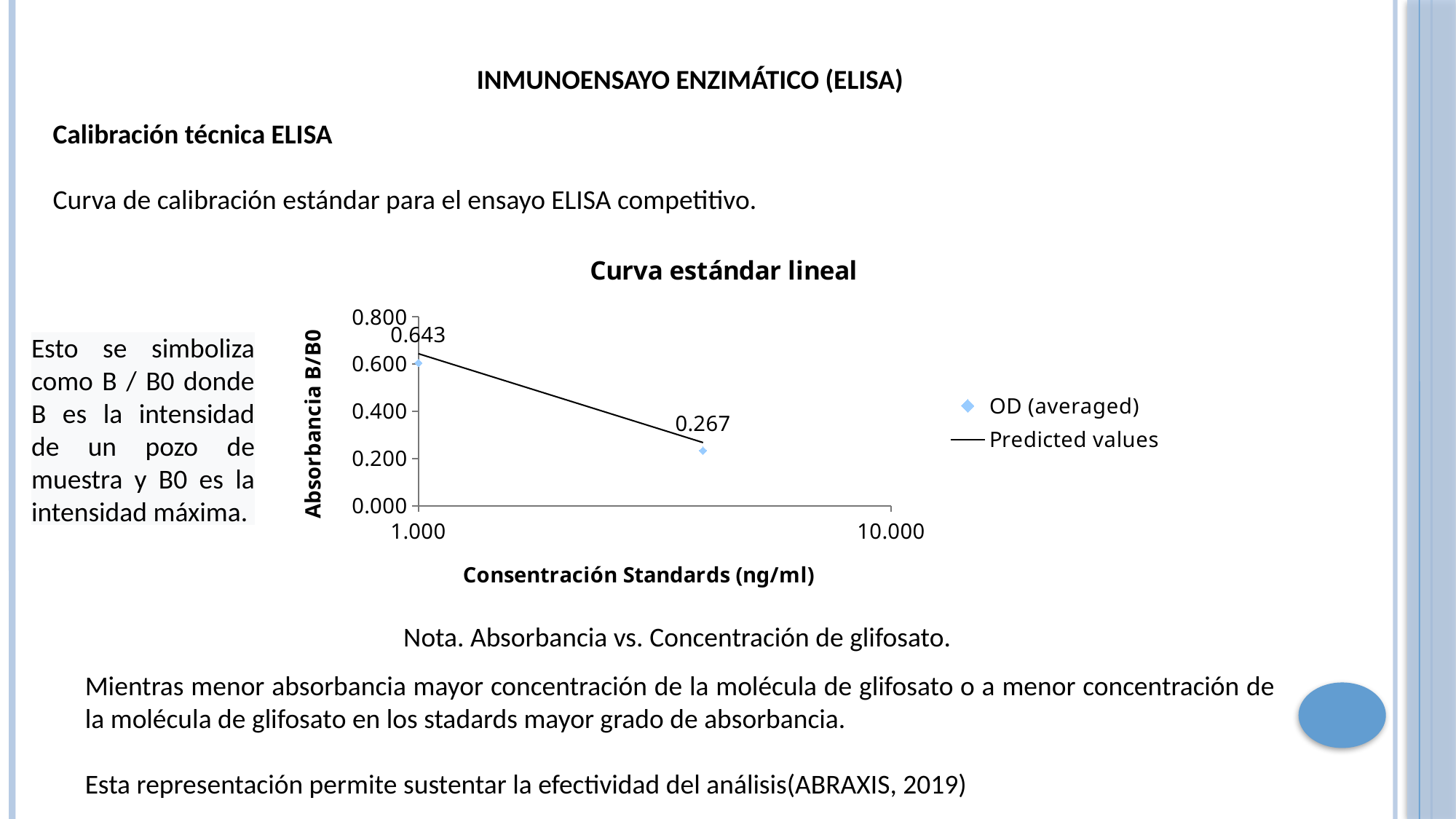
Is the second OD (averaged) point (the one at the higher concentration) greater or less than 0.400? less Is the OD (averaged) value at a concentration of 1.000 ng/ml greater or less than 0.400? greater Does the absorbance rise or fall as the concentration increases along the x axis? fall What is the lower of the two data labels shown on the Predicted values line? 0.267 What is the title of the chart? Curva estándar lineal What is the y-axis title of the chart? Absorbancia B/B0 What are the two series named in the chart legend? OD (averaged) and Predicted values How many OD (averaged) data points are plotted on the chart? 2 What is the higher of the two data labels shown on the Predicted values line? 0.643 How many series does the chart legend list? 2 What is the difference between the two labelled predicted values, 0.643 and 0.267? 0.376 What is the predicted value labelled at a concentration of 1.000 ng/ml? 0.643